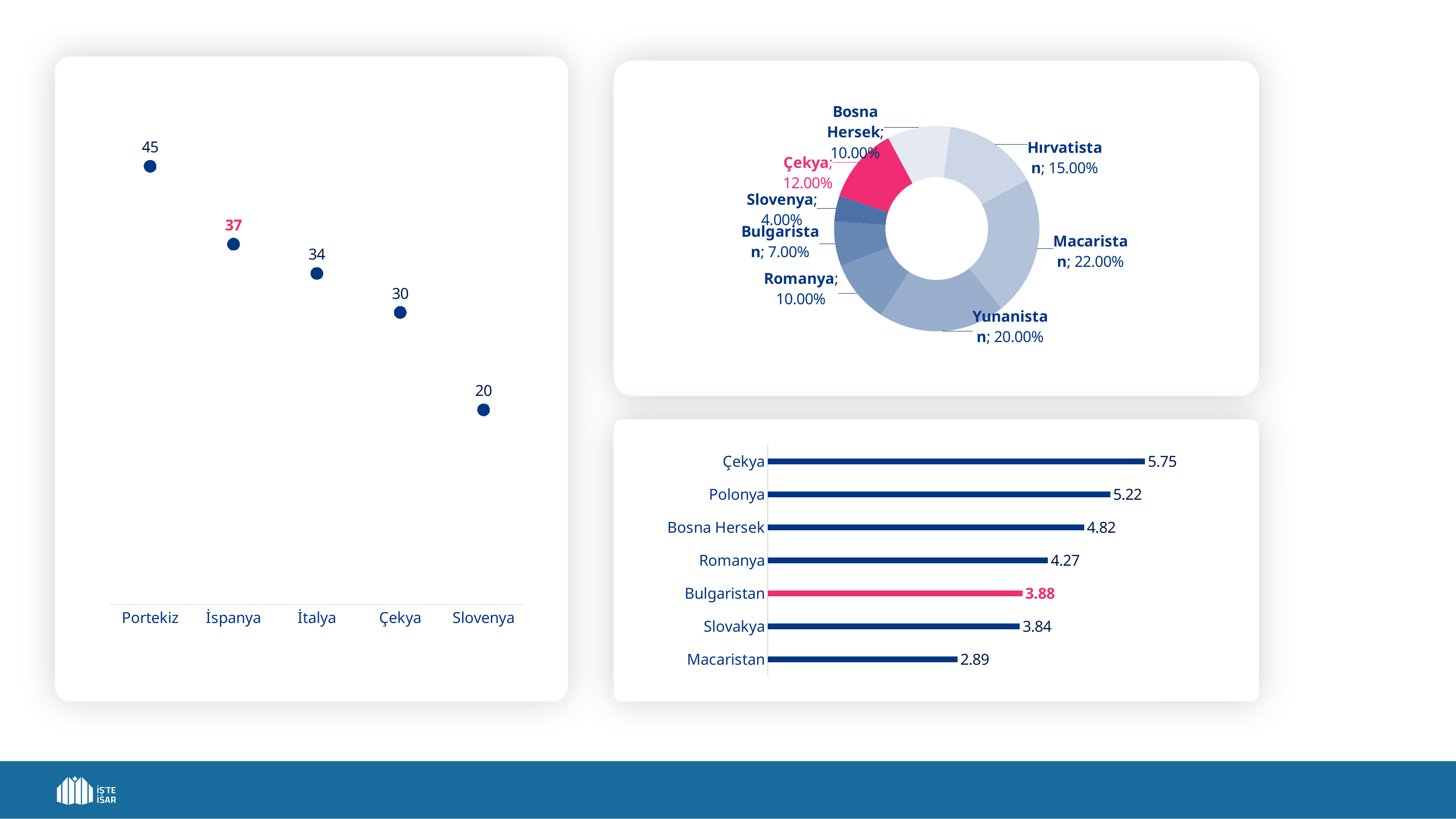
In the bar chart at the bottom right of the slide, what is the value for Bulgaristan? 3.88 In the donut chart at the top right of the slide, which slice is highlighted in pink? Çekya What kind of chart is at the bottom right of the slide? bar chart In the chart on the left of the slide, what is the difference between the values for İspanya and Çekya? 7 In the donut chart at the top right of the slide, which slice is the smallest? Slovenya In the bar chart at the bottom right of the slide, what is the difference between the values for Çekya and Macaristan? 2.86 In the chart on the left of the slide, what is the value for Portekiz? 45 In the chart on the left of the slide, do the values rise or fall from Portekiz to Slovenya? fall In the donut chart at the top right of the slide, which is larger, Hırvatistan or Çekya? Hırvatistan In the donut chart at the top right of the slide, what share does Macaristan have? 22.00% In the chart on the left of the slide, which category has the lowest value? Slovenya In the chart on the left of the slide, how many categories are plotted? 5